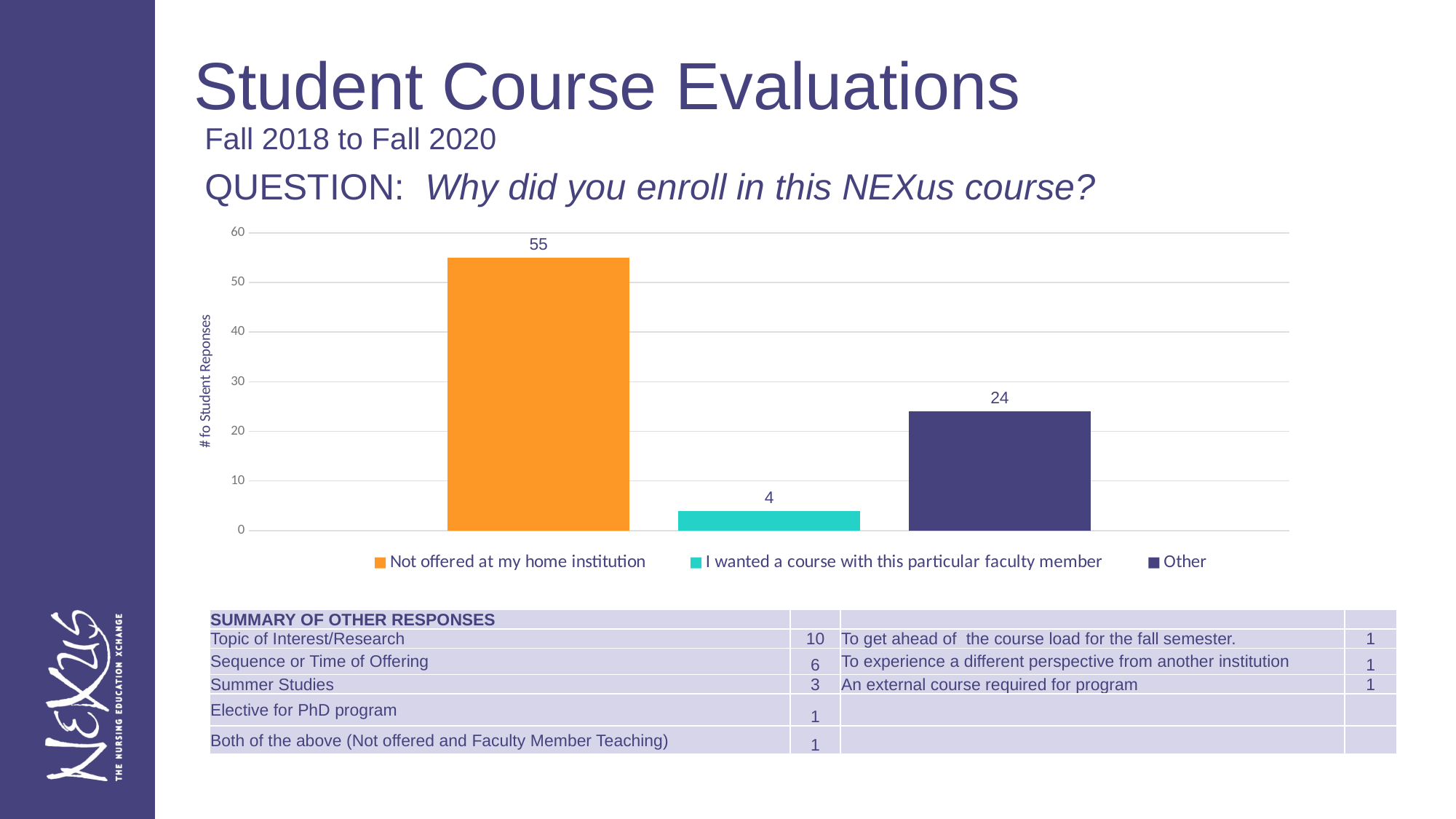
Which response category has the highest number of student responses? Not offered at my home institution How many response categories are shown in the chart? 3 Which response category has the lowest number of student responses? I wanted a course with this particular faculty member What kind of chart is shown on the slide? bar chart What is the label of the vertical axis of the chart? # fo Student Reponses How many student responses were for "Not offered at my home institution"? 55 What is the difference between the number of responses for "Not offered at my home institution" and "Other"? 31 Which has more responses: "Other" or "I wanted a course with this particular faculty member"? Other Is the value for "Other" greater or less than 30? less How many student responses were for "I wanted a course with this particular faculty member"? 4 What is the difference between the number of responses for "Other" and "I wanted a course with this particular faculty member"? 20 How many student responses were for "Other"? 24